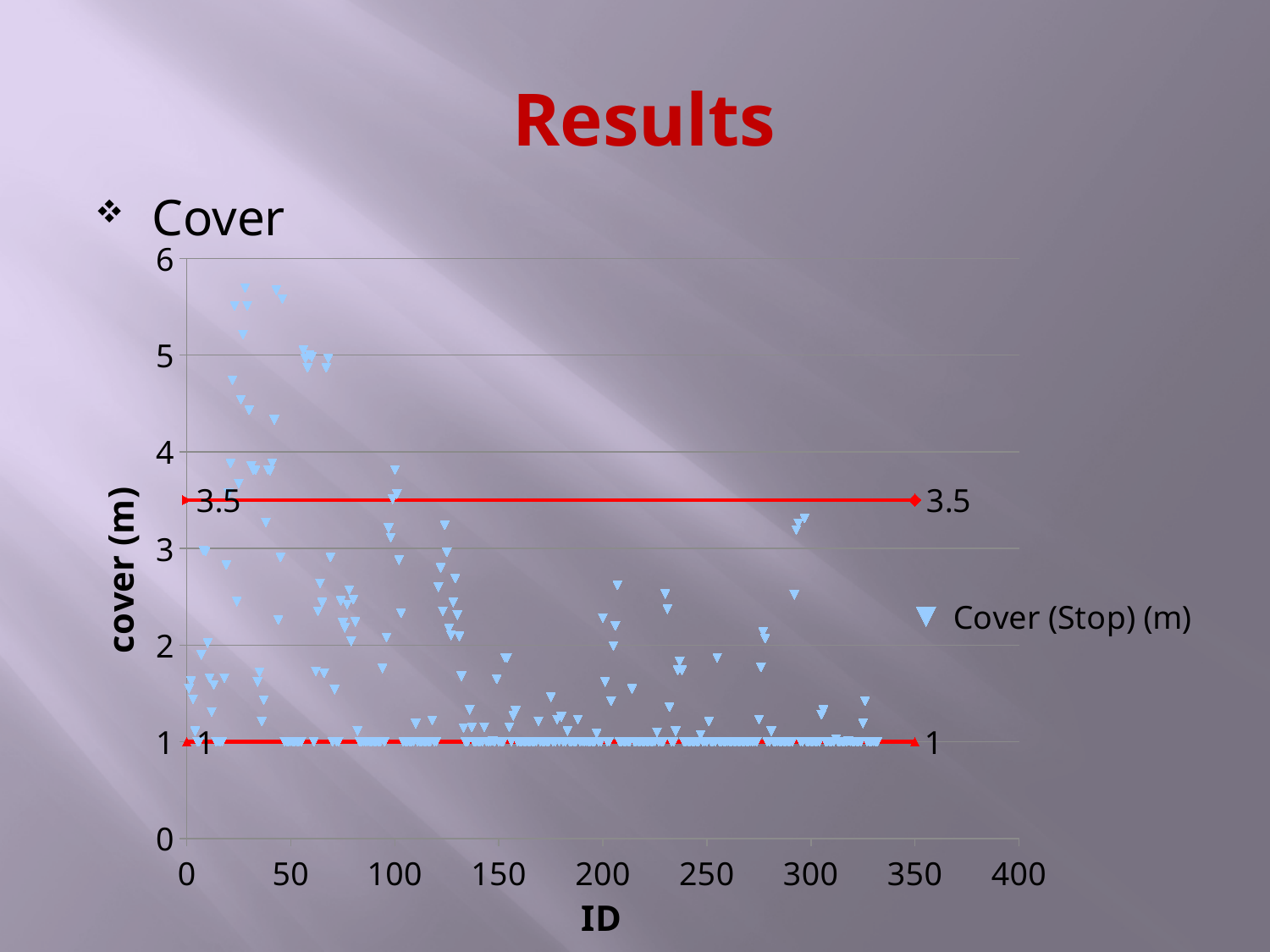
What is the largest tick value shown on the ID axis of the chart? 400 What is the title of the vertical axis of the chart? cover (m) What is the name of the series shown in the chart legend? Cover (Stop) (m) How many series does the chart legend list? 1 What kind of chart is shown on the slide? scatter chart What is the difference between the two labelled red reference lines in the chart? 2.5 Are the highest Cover (Stop) (m) values found at low or high ID values along the x axis? low Is the upper red reference line in the chart greater or less than 3? greater Is the highest plotted Cover (Stop) (m) value greater or less than 5? greater What value is labelled on the lower red horizontal reference line in the chart? 1 Which of the two red reference lines is higher, the one labelled 3.5 or the one labelled 1? 3.5 What value is labelled on the upper red horizontal reference line in the chart? 3.5